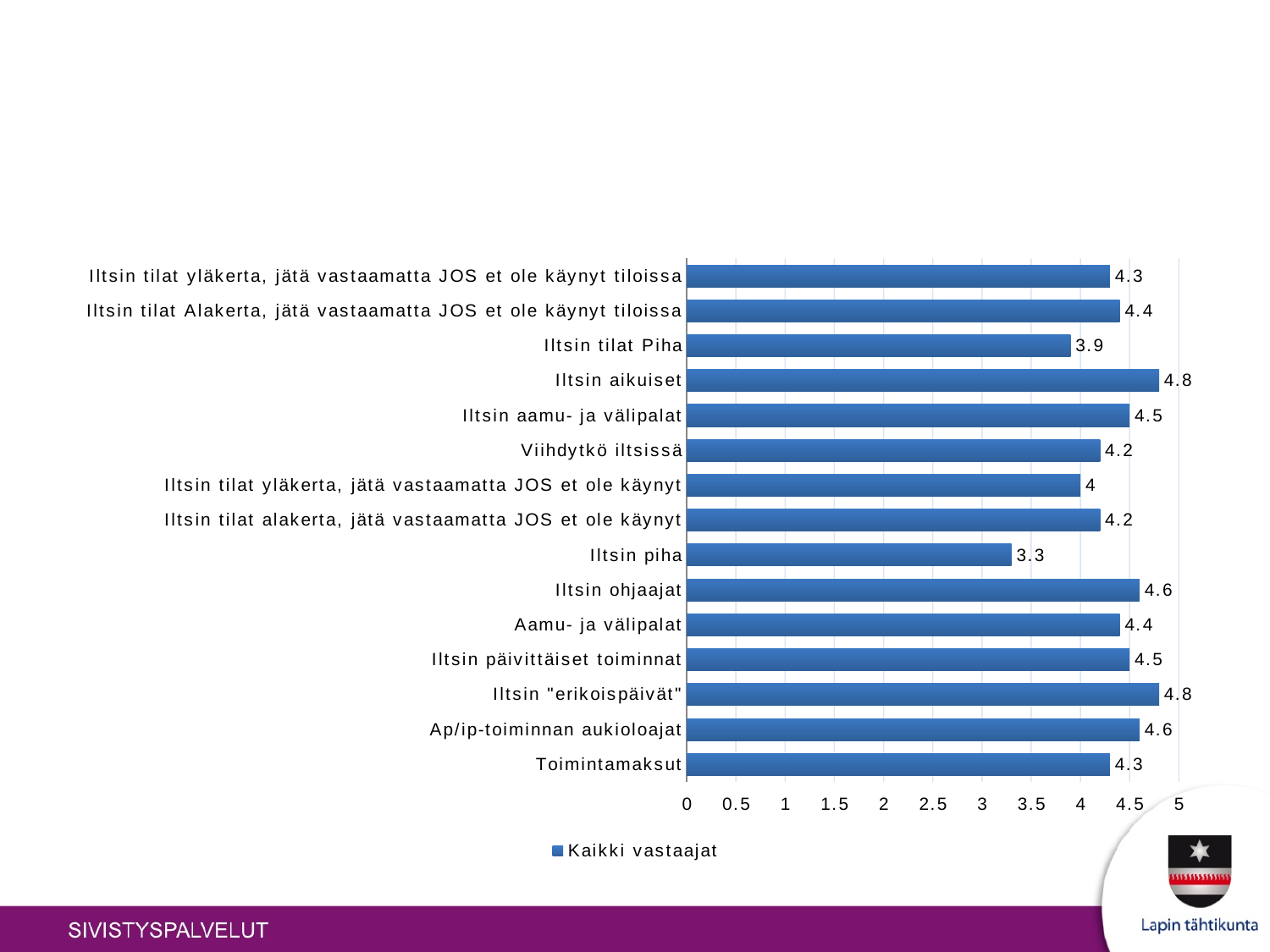
What is the value for Toimintamaksut? 4.3 Is the value for Iltsin piha greater or less than 3.5? less What is the value for Iltsin tilat Piha? 3.9 Which is larger, the value for Ap/ip-toiminnan aukioloajat or the value for Aamu- ja välipalat? Ap/ip-toiminnan aukioloajat What is the value for Iltsin ohjaajat? 4.6 How many series does the legend list? 1 How many categories are shown in the chart? 15 Which category has the lowest value? Iltsin piha What is the difference between the values for Iltsin aikuiset and Iltsin piha? 1.5 What is the value for Viihdytkö iltsissä? 4.2 What kind of chart is shown on the slide? bar chart What is the name of the series shown in the legend? Kaikki vastaajat